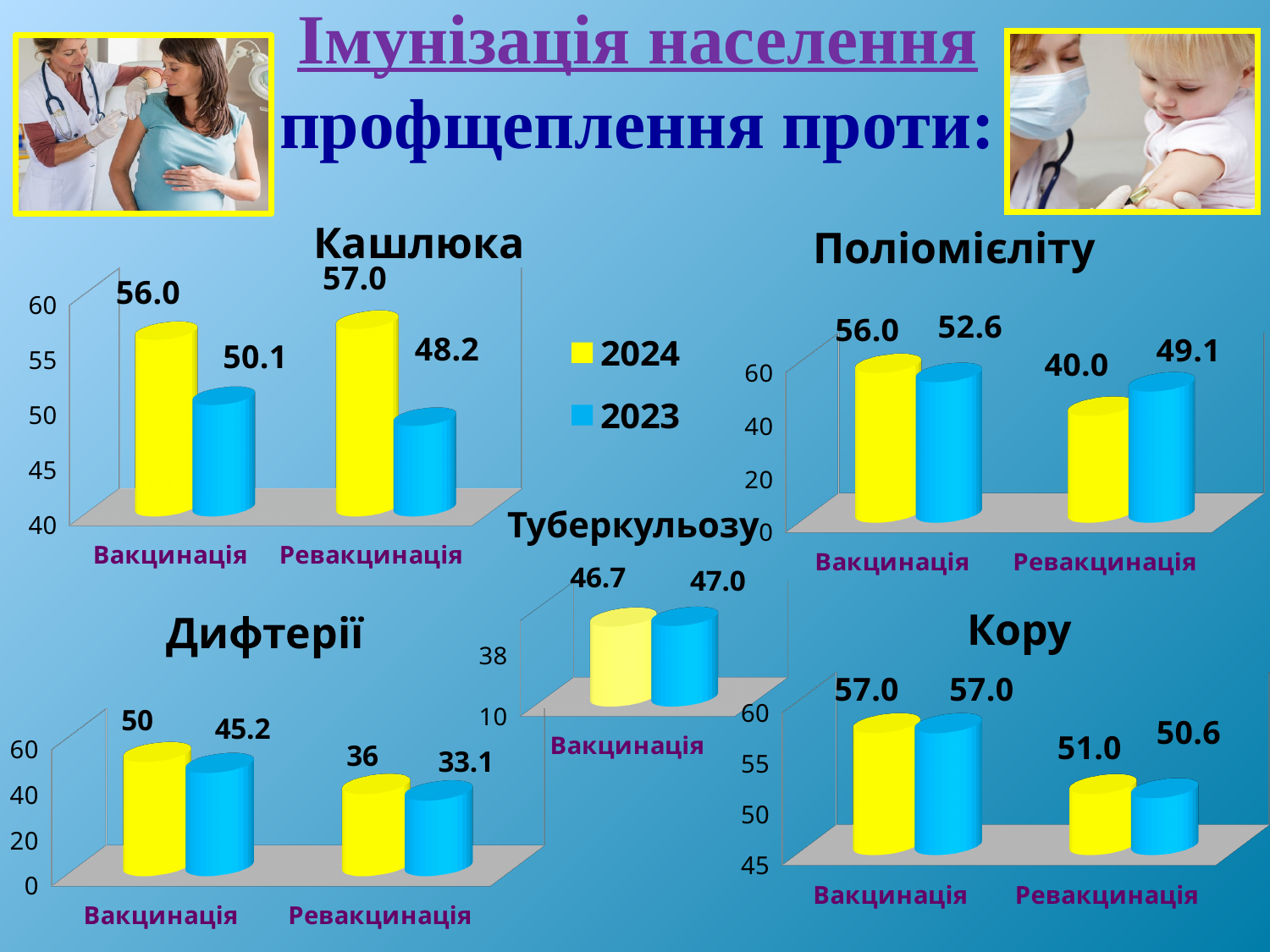
In the Кашлюка chart, what is the 2024 value for Вакцинація? 56.0 How many series does the legend list? 2 In the Кашлюка chart, what is the 2023 value for Ревакцинація? 48.2 In the Поліомієліту chart, what is the difference between the 2024 and 2023 values for Вакцинація? 3.4 In the Кору chart, which category has the lowest 2024 value? Ревакцинація In the Дифтерії chart, what is the 2024 value for Ревакцинація? 36 In the Дифтерії chart, what is the difference between the 2024 and 2023 values for Вакцинація? 4.8 In the Поліомієліту chart, which year has the larger value for Ревакцинація, 2024 or 2023? 2023 In the Поліомієліту chart, what is the 2023 value for Ревакцинація? 49.1 What kind of chart is the Кашлюка chart? Bar chart In the Кору chart, what is the 2023 value for Ревакцинація? 50.6 In the Туберкульозу chart, what is the 2023 value for Вакцинація? 47.0